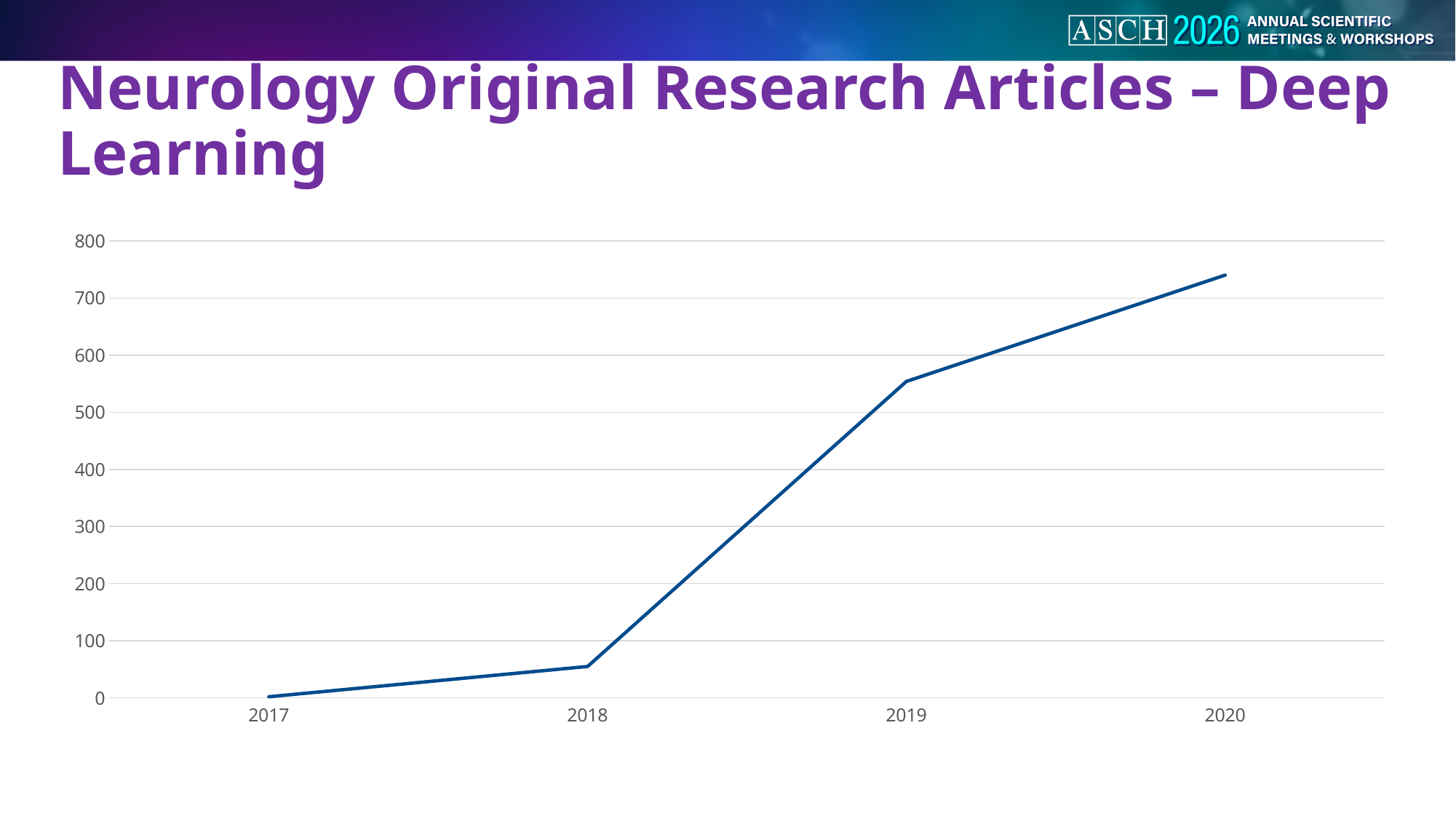
What is the highest tick value shown on the y axis? 800 What kind of chart is shown on the slide? line chart Which year has the highest value? 2020 Which year has the lowest value? 2017 Which is larger, the value for 2018 or the value for 2019? 2019 Is the value for 2018 greater or less than 100? less How many years are plotted on the x axis? 4 Is the value for 2019 greater or less than 600? less Do the values rise or fall from 2017 to 2020? rise Is the value for 2019 greater or less than 500? greater What is the first year shown on the x axis? 2017